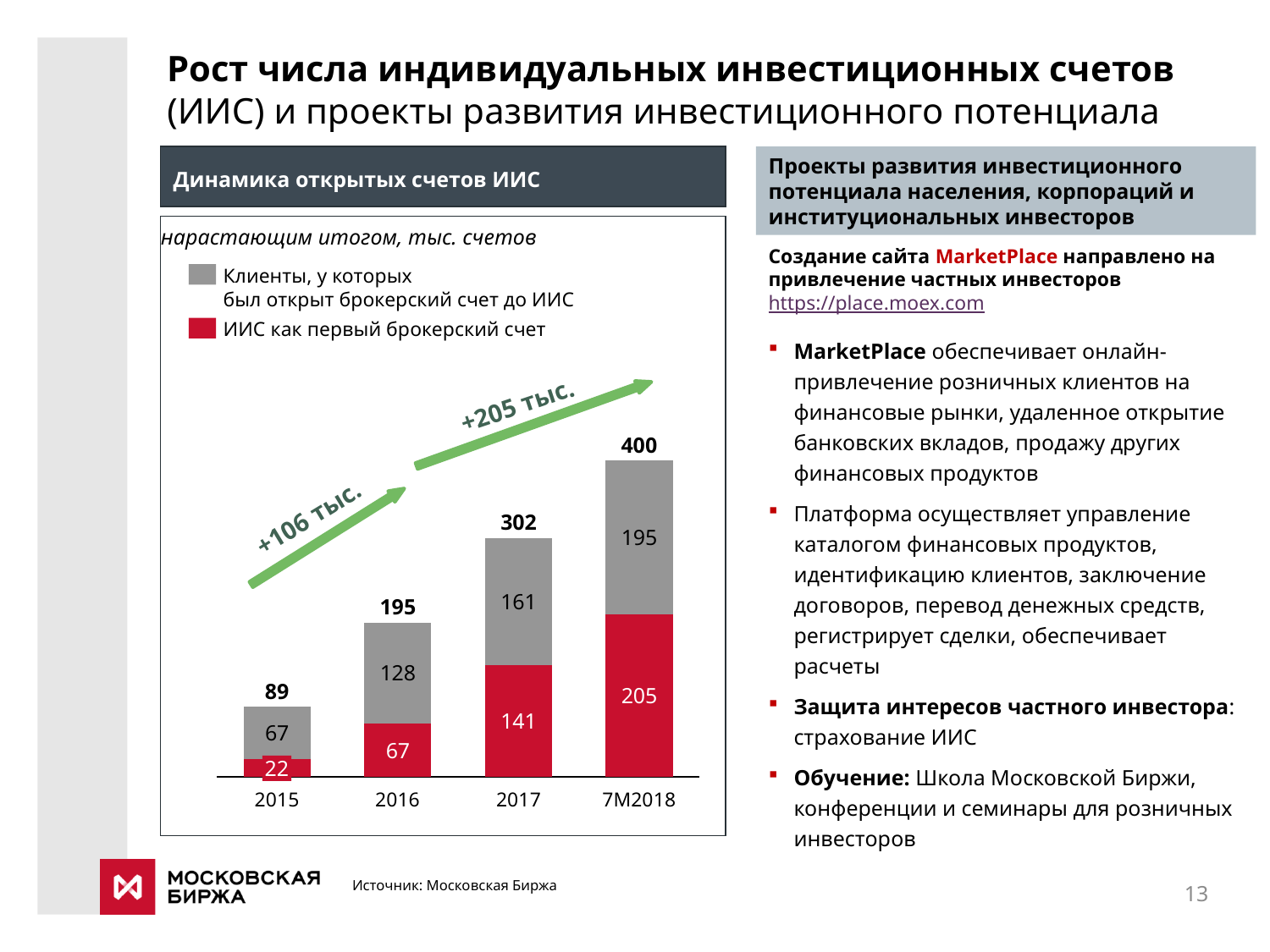
Which category has the highest value for "ИИС как первый брокерский счет"? 7M2018 What is the value of "ИИС как первый брокерский счет" for 2017? 141 How many categories are shown on the x axis of the chart? 4 What is the total of the stacked bar for 2015? 89 What is the value of "Клиенты, у которых был открыт брокерский счет до ИИС" for 2016? 128 Do the bar totals rise or fall from 2015 to 7M2018? rise How many series does the chart legend list? 2 Which category has the lowest total? 2015 For 7M2018, which is larger: "ИИС как первый брокерский счет" or "Клиенты, у которых был открыт брокерский счет до ИИС"? ИИС как первый брокерский счет What type of chart is shown under the heading "Динамика открытых счетов ИИС"? stacked bar chart What is the total of the stacked bar for 7M2018? 400 What is the difference between the totals for 2017 and 2016? 107